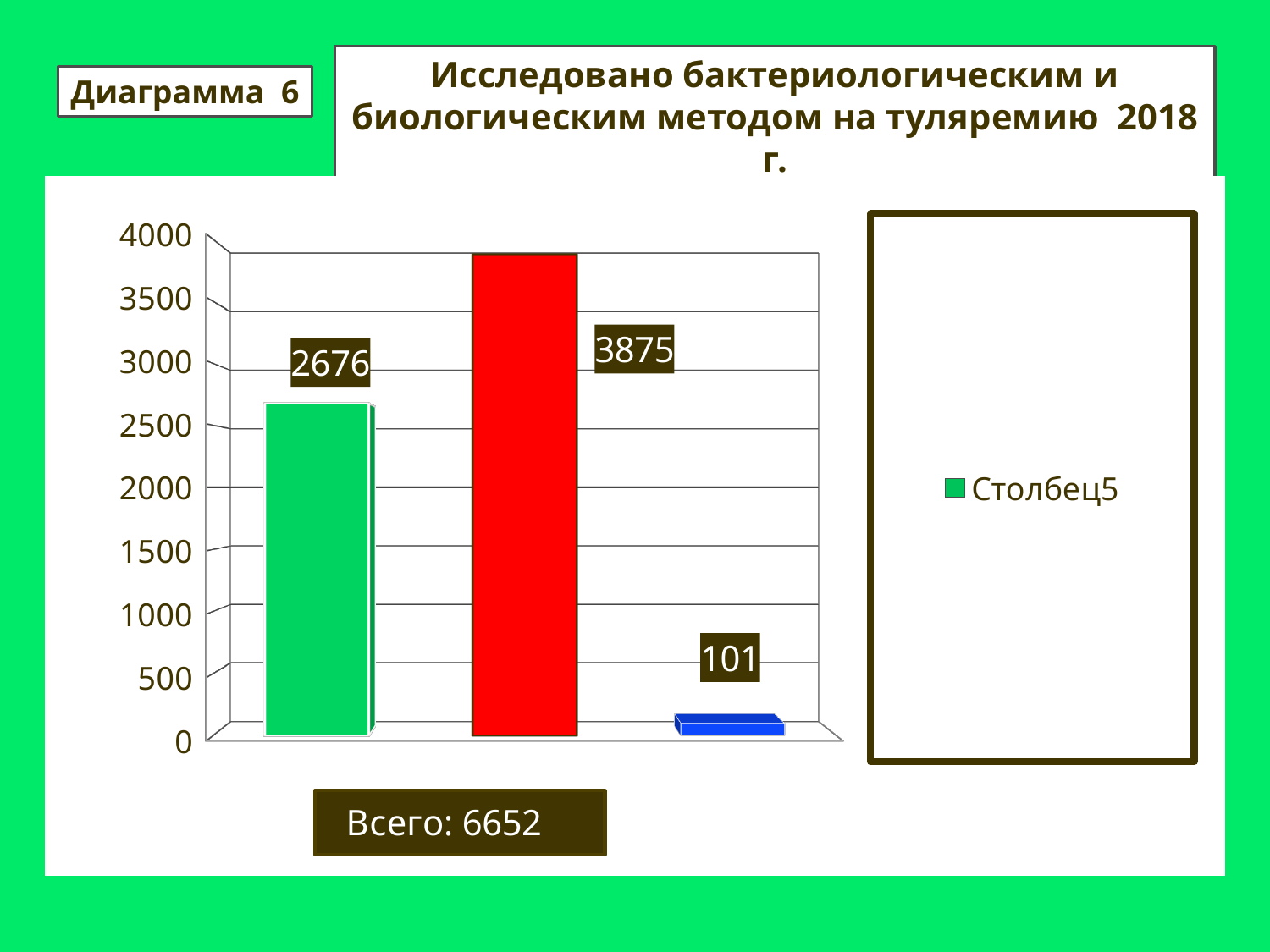
What value is shown on the blue bar? 101 What total is stated in the box below the chart? Всего: 6652 Which is larger, the green bar or the blue bar? The green bar What value is shown on the green bar? 2676 What type of chart is shown on the slide? Bar chart How many bars are plotted on the chart? 3 Is the value of the green bar greater or less than 3000? less Which bar has the lowest value? The blue bar (101) What value is shown on the red bar? 3875 What is the difference between the red bar and the green bar? 1199 What entry does the legend list? Столбец5 Which bar has the highest value? The red bar (3875)